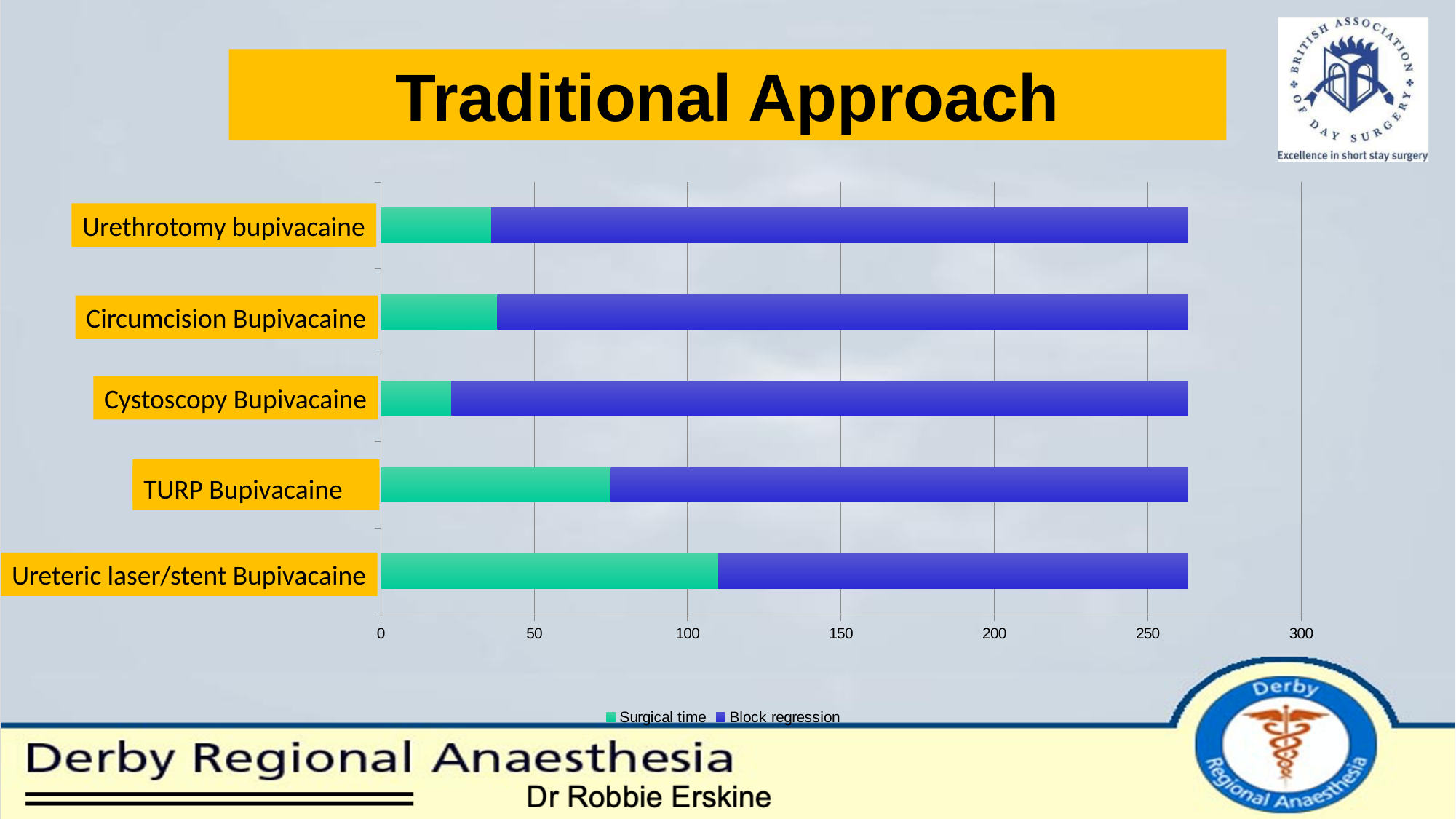
How many procedures (categories) are plotted on the chart? 5 Is the Surgical time for TURP Bupivacaine greater or less than 50? greater Is the total bar length for Urethrotomy bupivacaine greater or less than 250? greater Which procedure has the shortest Surgical time? Cystoscopy Bupivacaine How many series does the chart legend list? 2 Is the Surgical time for Cystoscopy Bupivacaine greater or less than 50? less What is the title shown above the chart? Traditional Approach Which procedure has the longest Surgical time? Ureteric laser/stent Bupivacaine Which has the larger Block regression segment, Cystoscopy Bupivacaine or Ureteric laser/stent Bupivacaine? Cystoscopy Bupivacaine What kind of chart is shown on the slide? Stacked bar chart Which two series are listed in the chart legend? Surgical time and Block regression